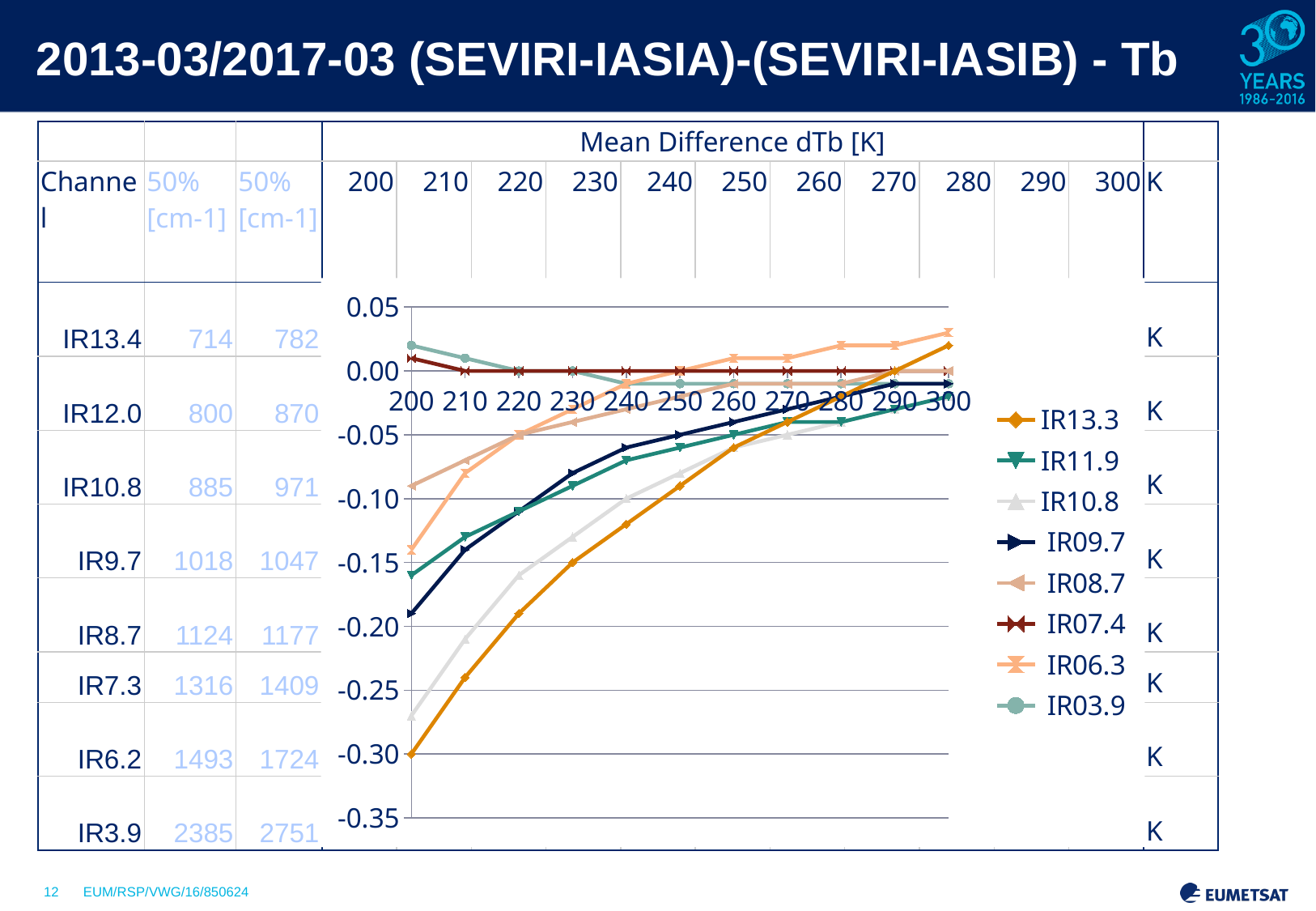
How many x-axis points (from 200 to 300) does the chart have? 11 Is the value for IR10.8 at 200 greater or less than -0.25? less How many series does the chart legend list? 8 What is the value of IR10.8 at 240? -0.10 What is the value of IR13.3 at 230? -0.15 What is the title shown above the chart? Mean Difference dTb [K] What kind of chart is shown on the slide? line chart Which series has the lowest value at 200? IR13.3 What is the value of IR07.4 at 220? 0.00 At 200, which is larger: IR11.9 or IR13.3? IR11.9 Does the IR13.3 series rise or fall as the x-axis value increases from 200 to 300? rise What is the value of IR13.3 at 200? -0.30